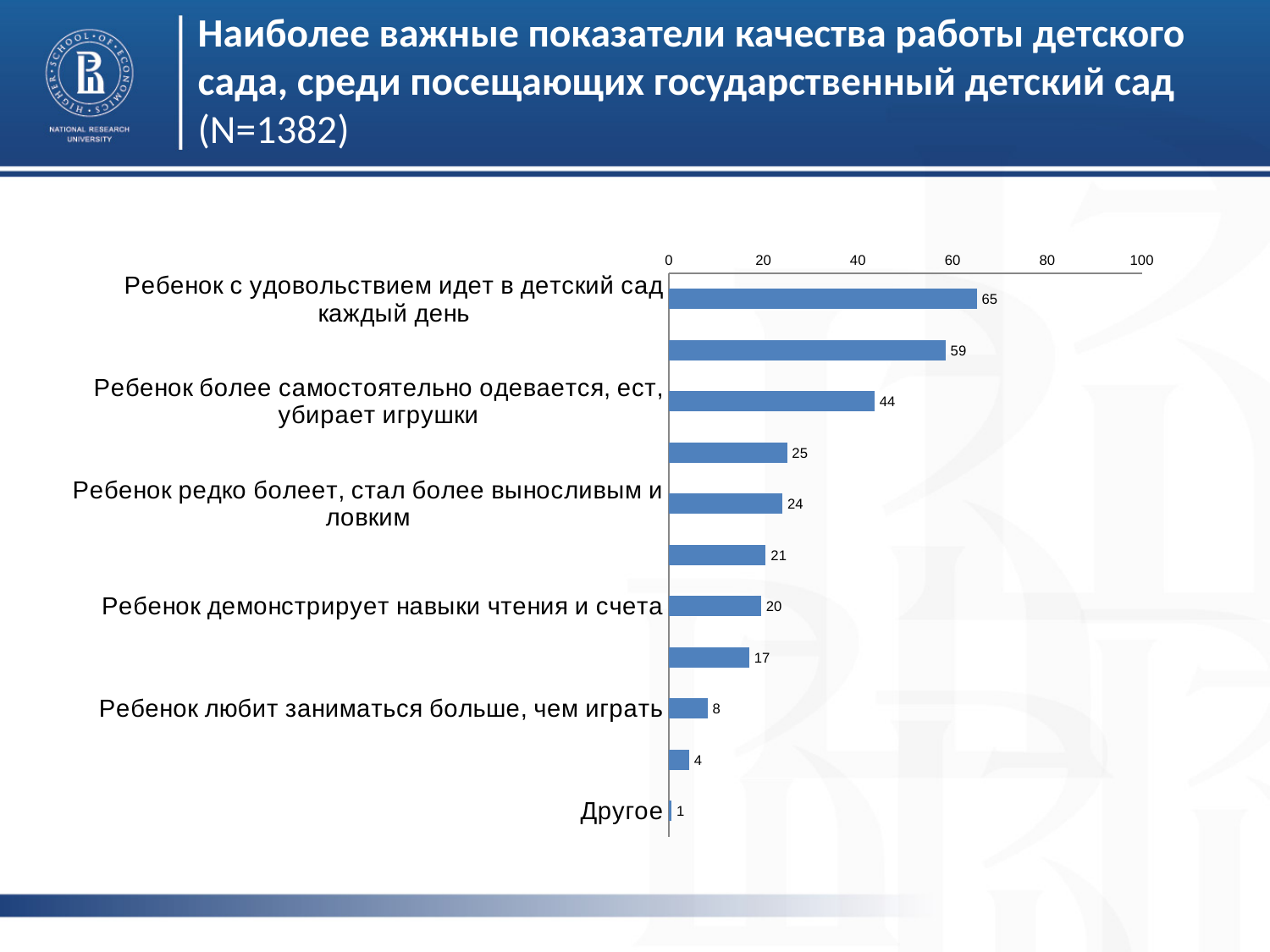
What value is shown for "Другое"? 1 What value is shown for "Ребенок с удовольствием идет в детский сад каждый день"? 65 What value is shown for "Ребенок более самостоятельно одевается, ест, убирает игрушки"? 44 What value is shown for "Ребенок демонстрирует навыки чтения и счета"? 20 What value is shown for "Ребенок любит заниматься больше, чем играть"? 8 What value is shown for "Ребенок редко болеет, стал более выносливым и ловким"? 24 What kind of chart is shown on the slide? Bar chart Which category has the highest value? Ребенок с удовольствием идет в детский сад каждый день Which category has the lowest value? Другое How many bars are plotted in the chart? 11 Which is larger: the value for "Ребенок редко болеет, стал более выносливым и ловким" or for "Ребенок любит заниматься больше, чем играть"? Ребенок редко болеет, стал более выносливым и ловким What is the difference between the values for "Ребенок с удовольствием идет в детский сад каждый день" and "Ребенок более самостоятельно одевается, ест, убирает игрушки"? 21